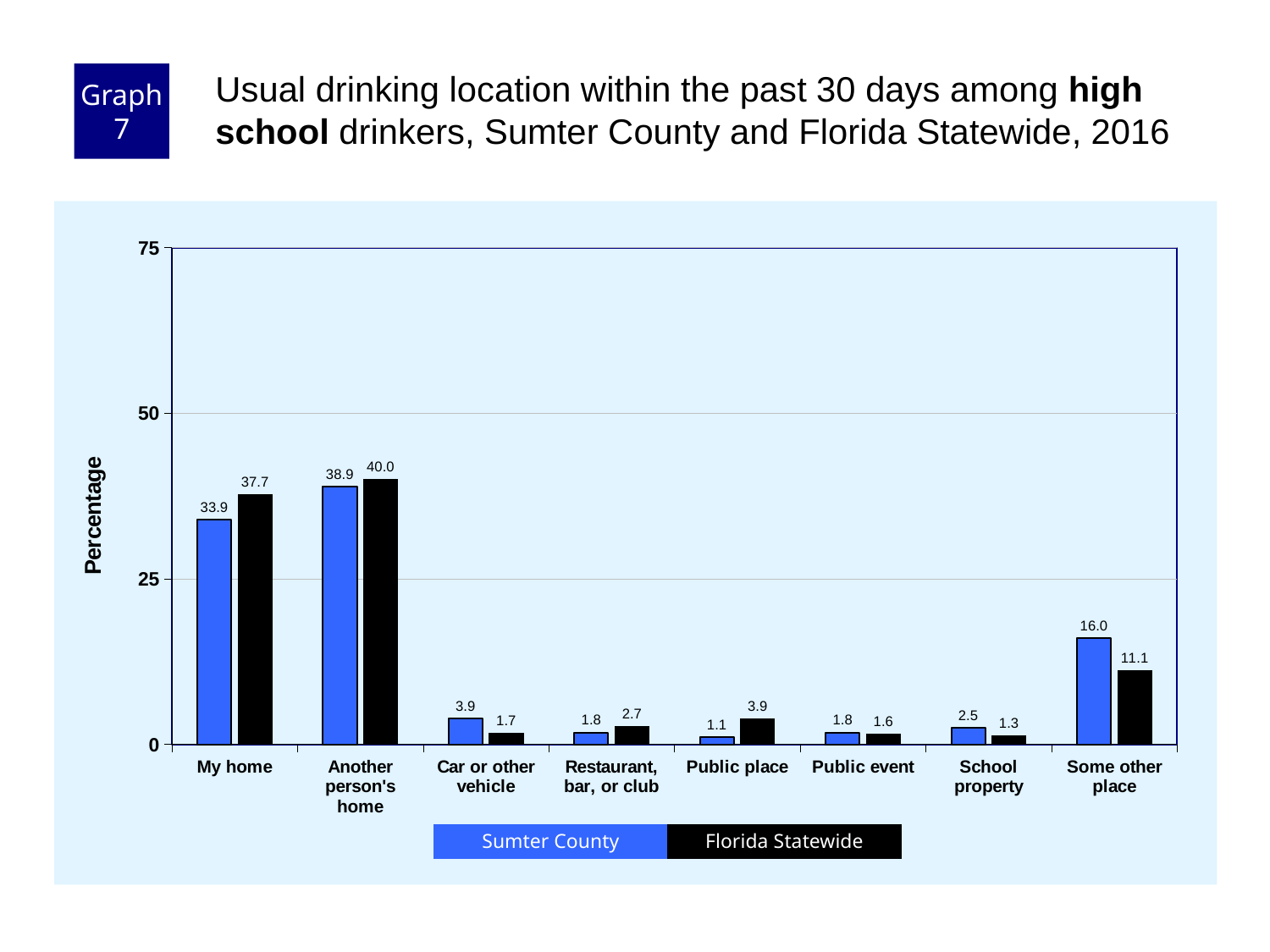
Which category has the highest Florida Statewide value? Another person's home What is the difference between the Florida Statewide and Sumter County values for "My home"? 3.8 How many categories are shown on the x axis? 8 What kind of chart is shown on the slide? Bar chart Which category has the lowest Sumter County value? Public place What is the Sumter County value for "Some other place"? 16.0 Which is larger for "Public place": Sumter County or Florida Statewide? Florida Statewide How many series does the legend list? 2 What is the difference between the Sumter County and Florida Statewide values for "Some other place"? 4.9 What is the Sumter County value for "My home"? 33.9 What is the Florida Statewide value for "Another person's home"? 40.0 Is the Sumter County value for "Another person's home" greater or less than 25? greater